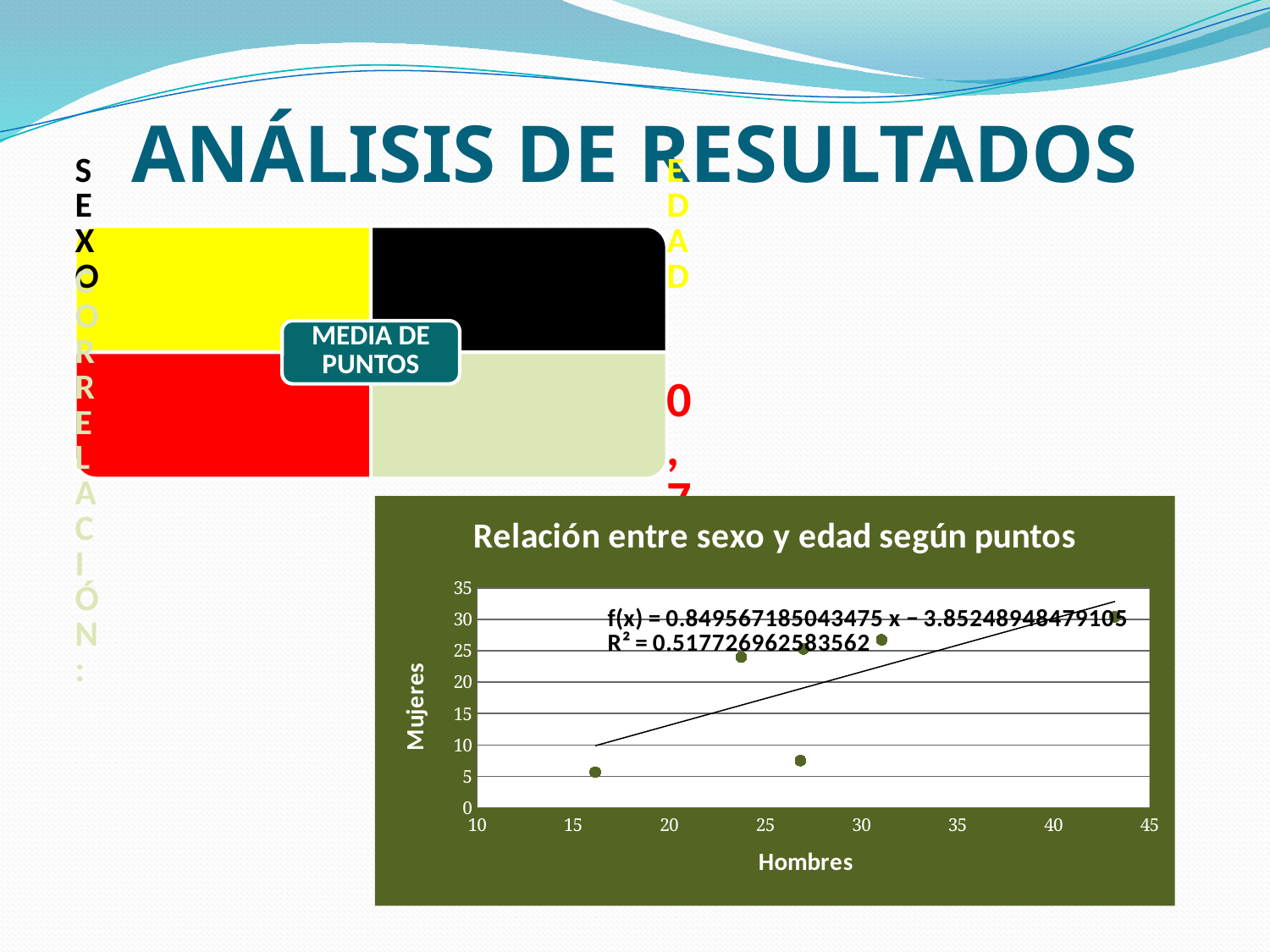
What kind of chart is shown under the title "Relación entre sexo y edad según puntos"? scatter chart What is the R² value shown on the scatter chart's trendline? 0.517726962583562 Is the Mujeres value of the rightmost point in the scatter chart greater or less than 20? greater Does the trendline in the scatter chart rise or fall as Hombres increases? rise What is the maximum value shown on the y axis (Mujeres) of the scatter chart? 35 What is the label of the x axis of the scatter chart? Hombres Is the Hombres value of the leftmost point in the scatter chart greater or less than 20? less Is the Mujeres value of the leftmost point in the scatter chart greater or less than 10? less How many data points are plotted in the scatter chart? 6 What is the title of the chart on the slide? Relación entre sexo y edad según puntos What is the trendline equation shown on the scatter chart? f(x) = 0.849567185043475 x − 3.85248948479105